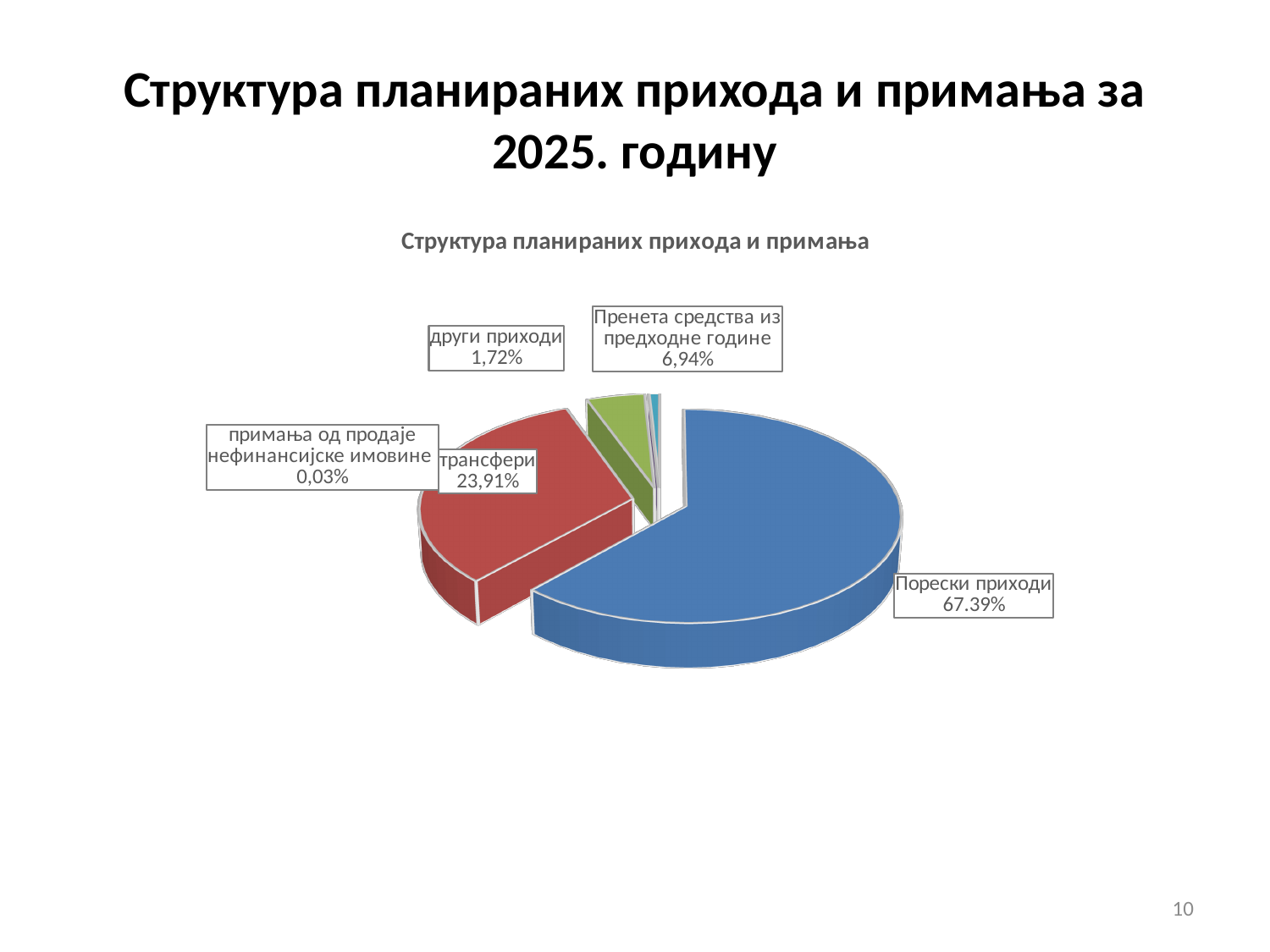
Which category has the smallest slice of the pie? примања од продаје нефинансијске имовине What colour is the slice for Порески приходи? blue What is the chart's title? Структура планираних прихода и примања What share of the pie is labelled for трансфери? 23,91% What kind of chart is shown on the slide? pie chart How many slices does the pie chart have? 5 What share of the pie is labelled for други приходи? 1,72% Which is larger, the slice for трансфери or the slice for Пренета средства из предходне године? трансфери Which category has the largest slice of the pie? Порески приходи What share of the pie is labelled for Пренета средства из предходне године? 6,94% What share of the pie is labelled for примања од продаје нефинансијске имовине? 0,03% What share of the pie is labelled for Порески приходи? 67.39%